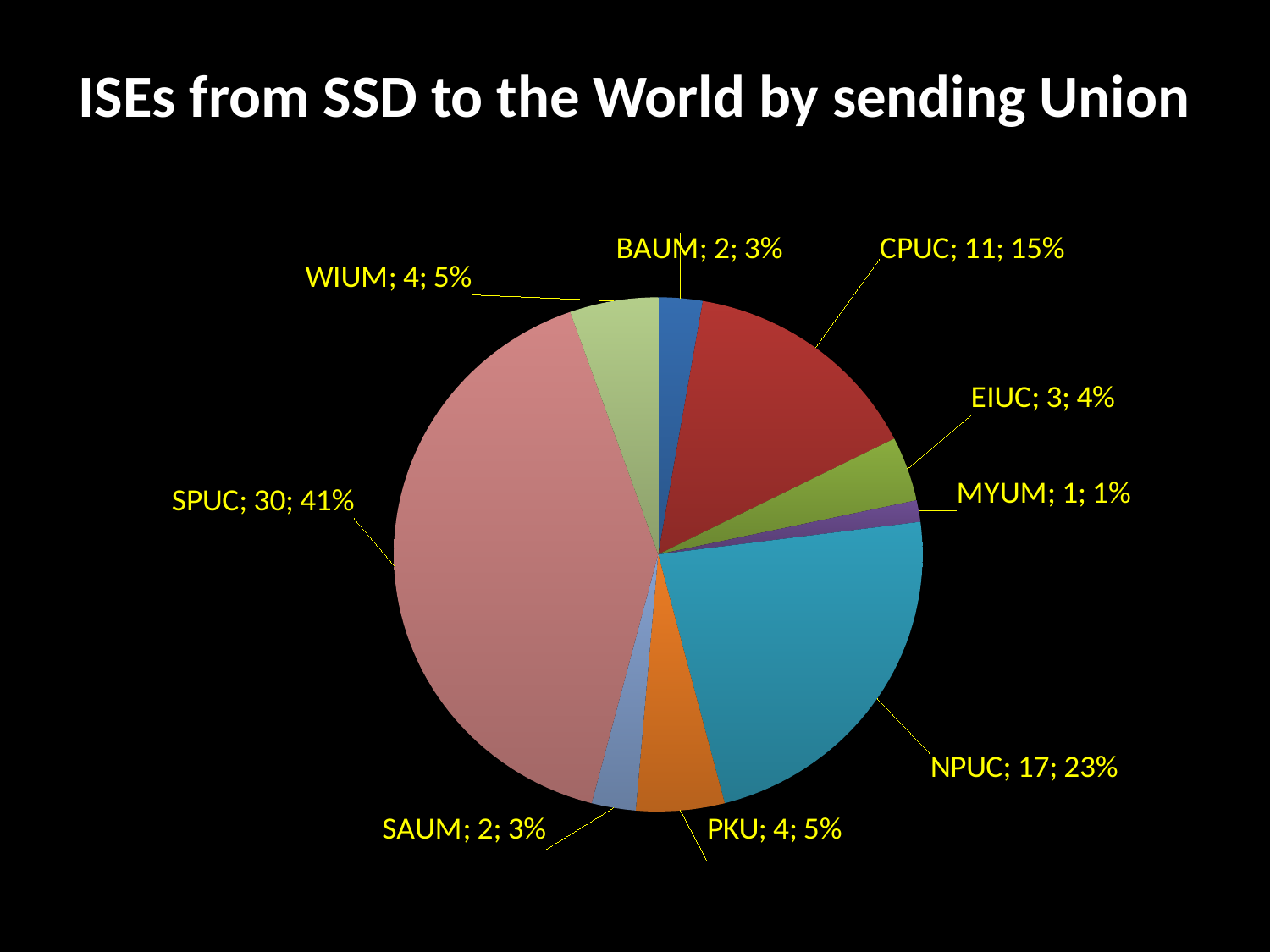
What percentage share does NPUC have? 23% What is the value for SPUC? 30 Which union has the largest slice? SPUC What is the value for WIUM? 4 How many unions are shown in the pie chart? 9 What is the difference between the values for SPUC and NPUC? 13 What is the value for CPUC? 11 Which union has the smallest slice? MYUM What kind of chart is shown on the slide? Pie chart What percentage share does SPUC have? 41% Which is larger, the value for CPUC or the value for EIUC? CPUC What is the title of the chart? ISEs from SSD to the World by sending Union